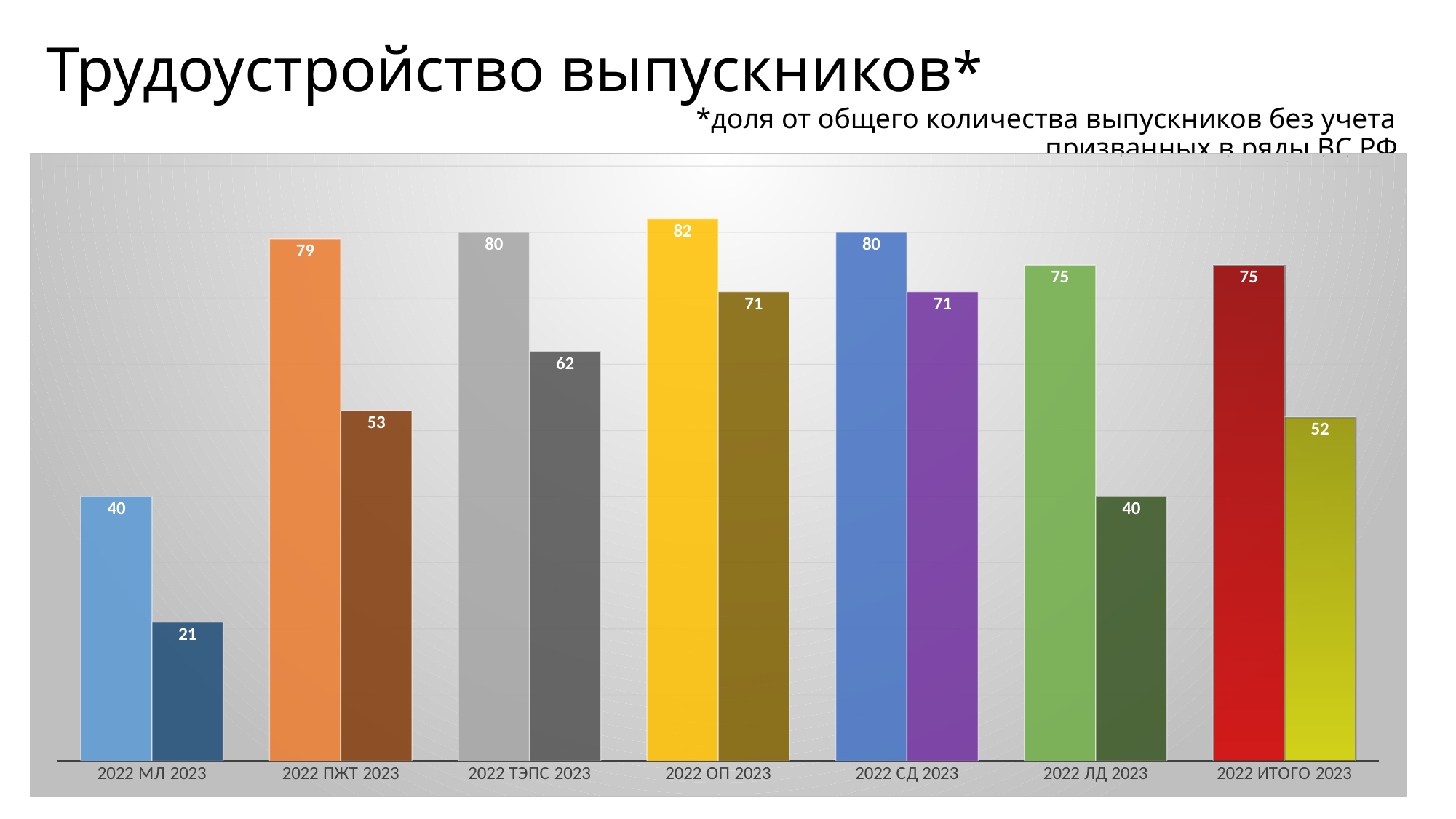
Which group has the highest 2022 value? ОП What is the 2022 value for МЛ? 40 What is the title of the slide? Трудоустройство выпускников* Which is larger: the 2023 value for ОП or the 2023 value for ТЭПС? ОП What is the difference between the 2022 and 2023 values for ЛД? 35 What kind of chart is shown on the slide? Bar chart What is the 2023 value for ПЖТ? 53 How many groups of bars are shown on the x axis? 7 What is the 2023 value for ТЭПС? 62 What is the 2022 value for ИТОГО? 75 What is the difference between the 2022 and 2023 values for ИТОГО? 23 Which group has the lowest 2023 value? МЛ